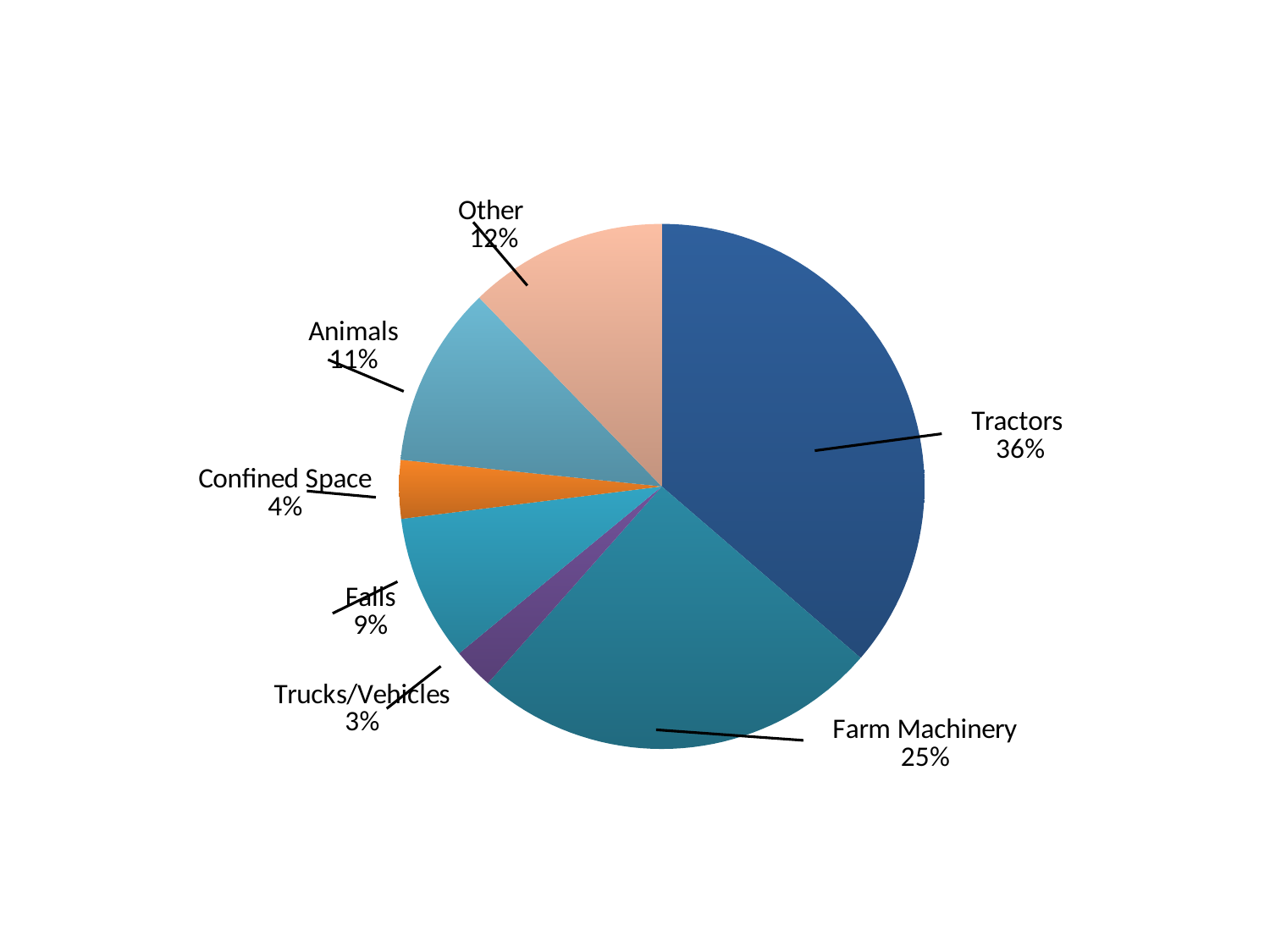
What colour is the Confined Space slice? orange Which category has the largest slice of the pie? Tractors What percentage is shown for Farm Machinery? 25% What kind of chart is shown on the slide? pie chart What percentage is shown for Confined Space? 4% Which is larger, the share for Other or the share for Falls? Other Which category has the smallest slice of the pie? Trucks/Vehicles What percentage is shown for Animals? 11% What is the difference in percentage points between Tractors and Farm Machinery? 11 What share of the pie does Tractors account for? 36% What is the difference in percentage points between Other and Animals? 1 How many categories are shown in the pie chart? 7